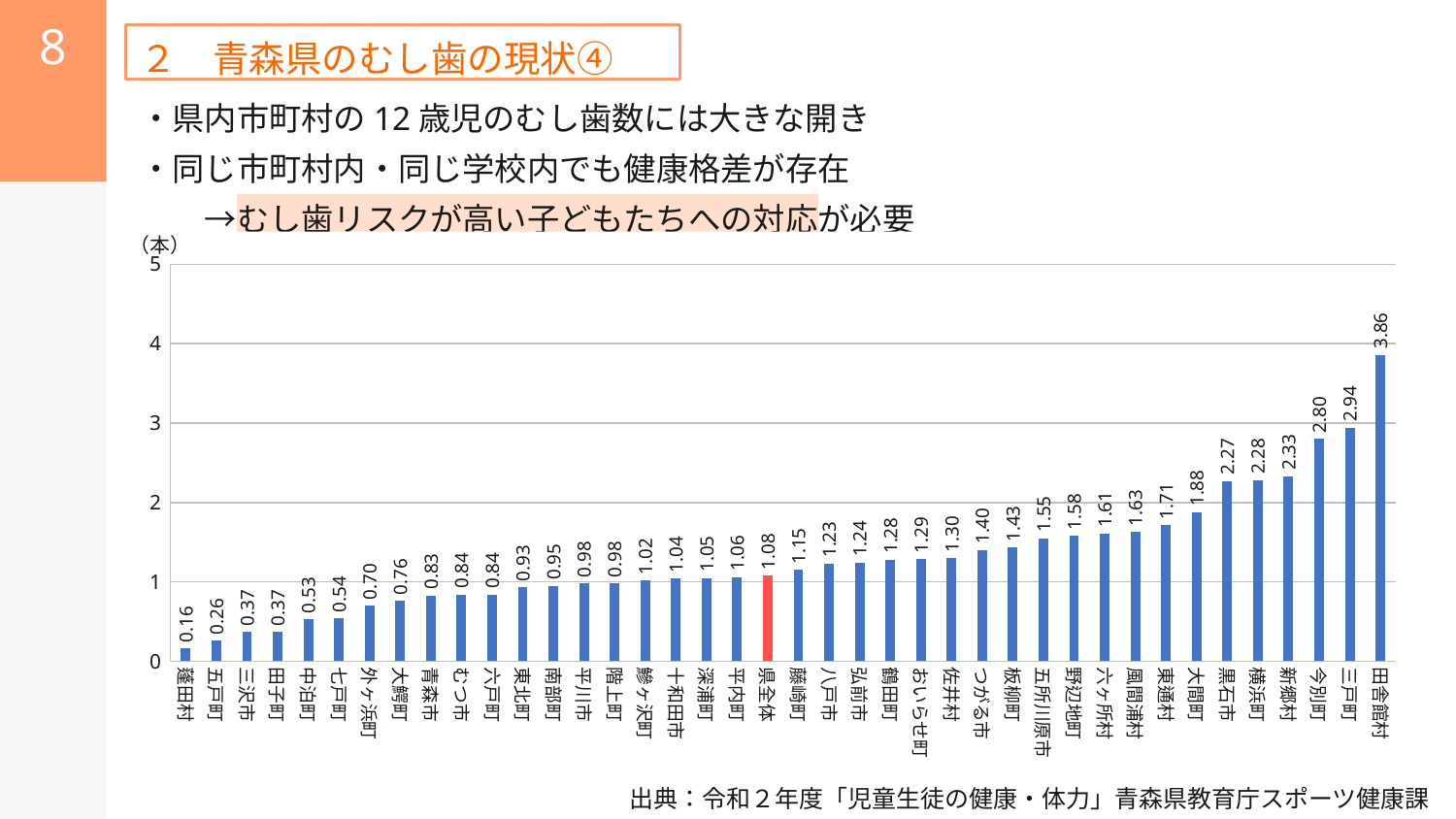
What kind of chart is shown on the slide? bar chart What is the value for 青森市 in the chart? 0.83 Is the value for 今別町 greater or less than 3? less What is the value for 八戸市 in the chart? 1.23 Which category has the highest value in the chart? 田舎館村 What is the difference between the values for 田舎館村 and 三戸町? 0.92 Which bar in the chart is coloured red instead of blue? 県全体 What is the difference between the values for 県全体 and 蓬田村? 0.92 What is the value for 県全体 in the chart? 1.08 Which category has the lowest value in the chart? 蓬田村 Which has a larger value, 黒石市 or 大間町? 黒石市 How many bars are plotted in the chart? 40